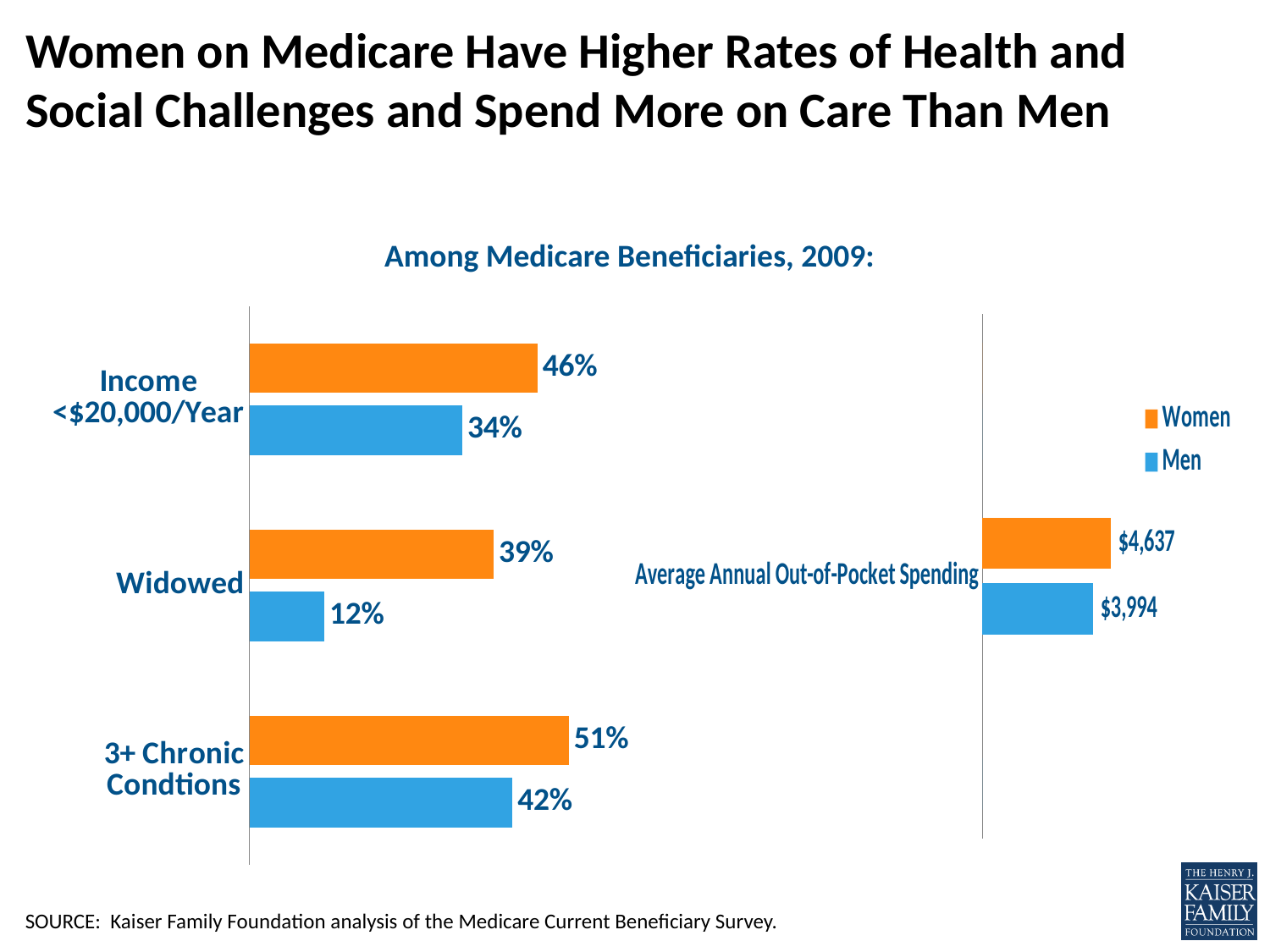
In the Average Annual Out-of-Pocket Spending chart, what is the difference between the Women and Men values? $643 In the left chart, what is the value for Men in the Widowed category? 12% In the left chart, which category has the highest value for Women? 3+ Chronic Conditions In the left chart, what is the difference between the Women and Men values in the Widowed category? 27 percentage points In the Average Annual Out-of-Pocket Spending chart, what is the value for Women? $4,637 What type of chart is the left chart? Bar chart In the left chart, which is larger in the Income <$20,000/Year category: the value for Women or for Men? Women How many categories are shown in the left chart? 3 In the left chart, what is the value for Women in the Income <$20,000/Year category? 46% In the Average Annual Out-of-Pocket Spending chart, what is the value for Men? $3,994 In the left chart, what is the value for Men in the 3+ Chronic Conditions category? 42% In the left chart, which category has the lowest value for Men? Widowed